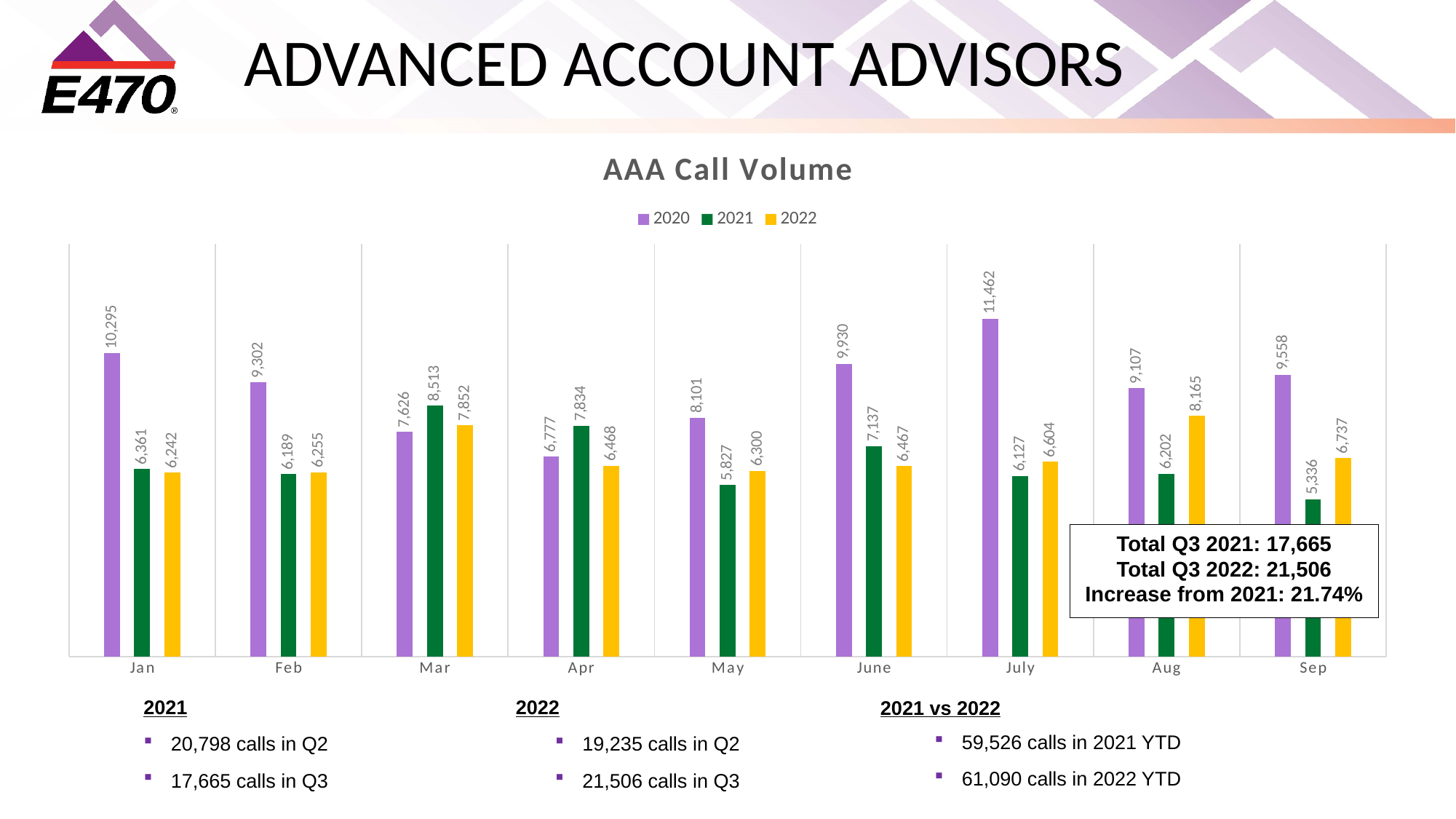
What is the 2021 call volume for Mar? 8,513 What is the title of the chart? AAA Call Volume Which month has the highest 2020 call volume? July What type of chart is shown on the slide? Bar chart Which colour represents the 2022 series in the chart? Yellow Which month has the lowest 2021 call volume? Sep What is the difference between the 2020 and 2021 call volumes in Jan? 3,934 What is the 2020 call volume for July? 11,462 How many series does the legend list? 3 What is the 2022 call volume for Aug? 8,165 How many months are shown on the x axis? 9 In Apr, which series has the larger call volume, 2021 or 2022? 2021